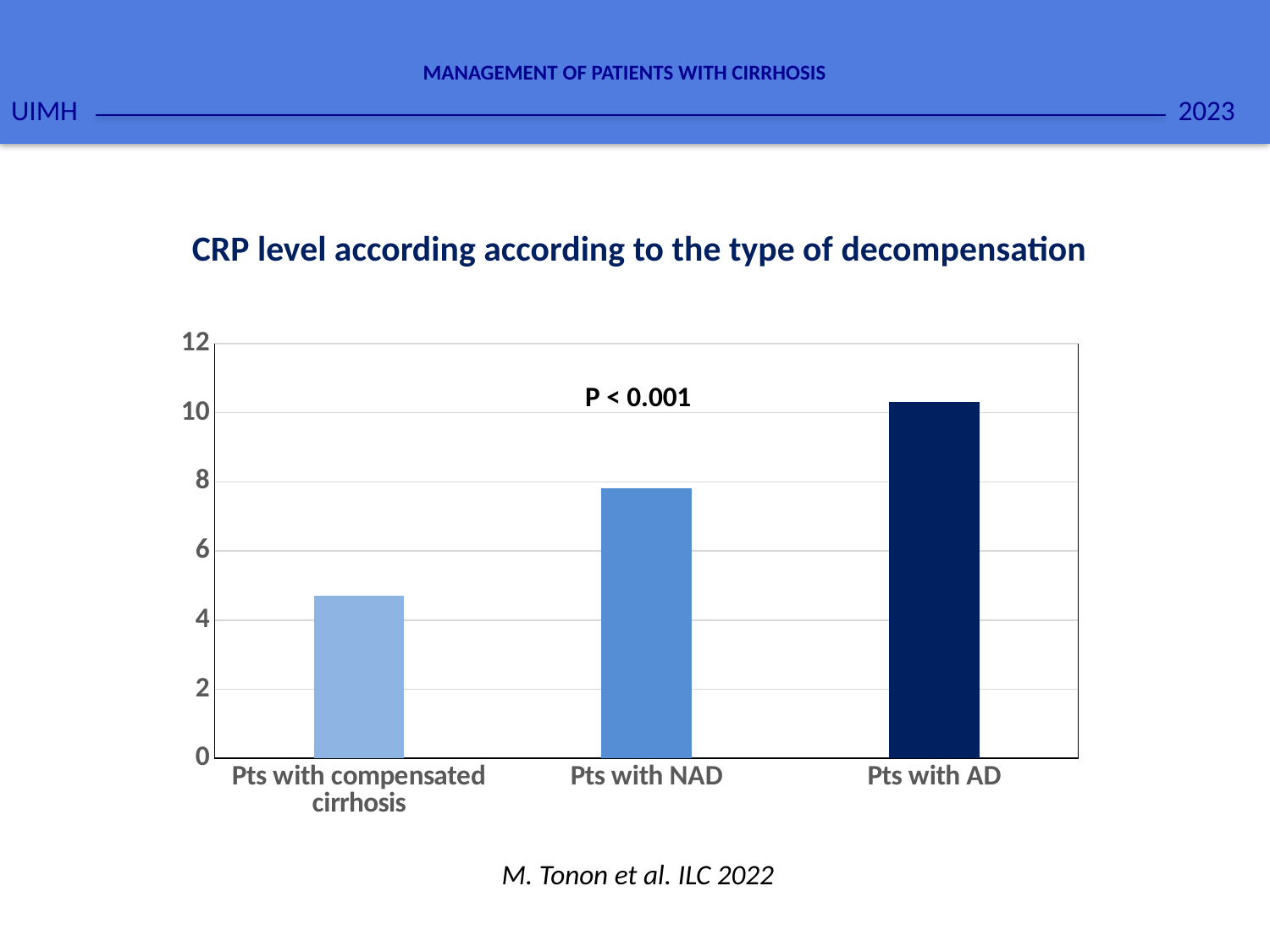
Which category has the highest CRP level in the chart? Pts with AD Is the value for Pts with compensated cirrhosis greater or less than 4? greater Do the CRP values rise or fall from left to right across the categories? rise What kind of chart is shown on the slide? bar chart Which category has the lowest CRP level in the chart? Pts with compensated cirrhosis Is the value for Pts with NAD greater or less than 6? greater Which is larger, the value for Pts with NAD or the value for Pts with compensated cirrhosis? Pts with NAD What is the title of the chart? CRP level according according to the type of decompensation How many categories are shown on the x axis of the chart? 3 Is the value for Pts with AD greater or less than 10? greater What p-value is printed on the chart? P < 0.001